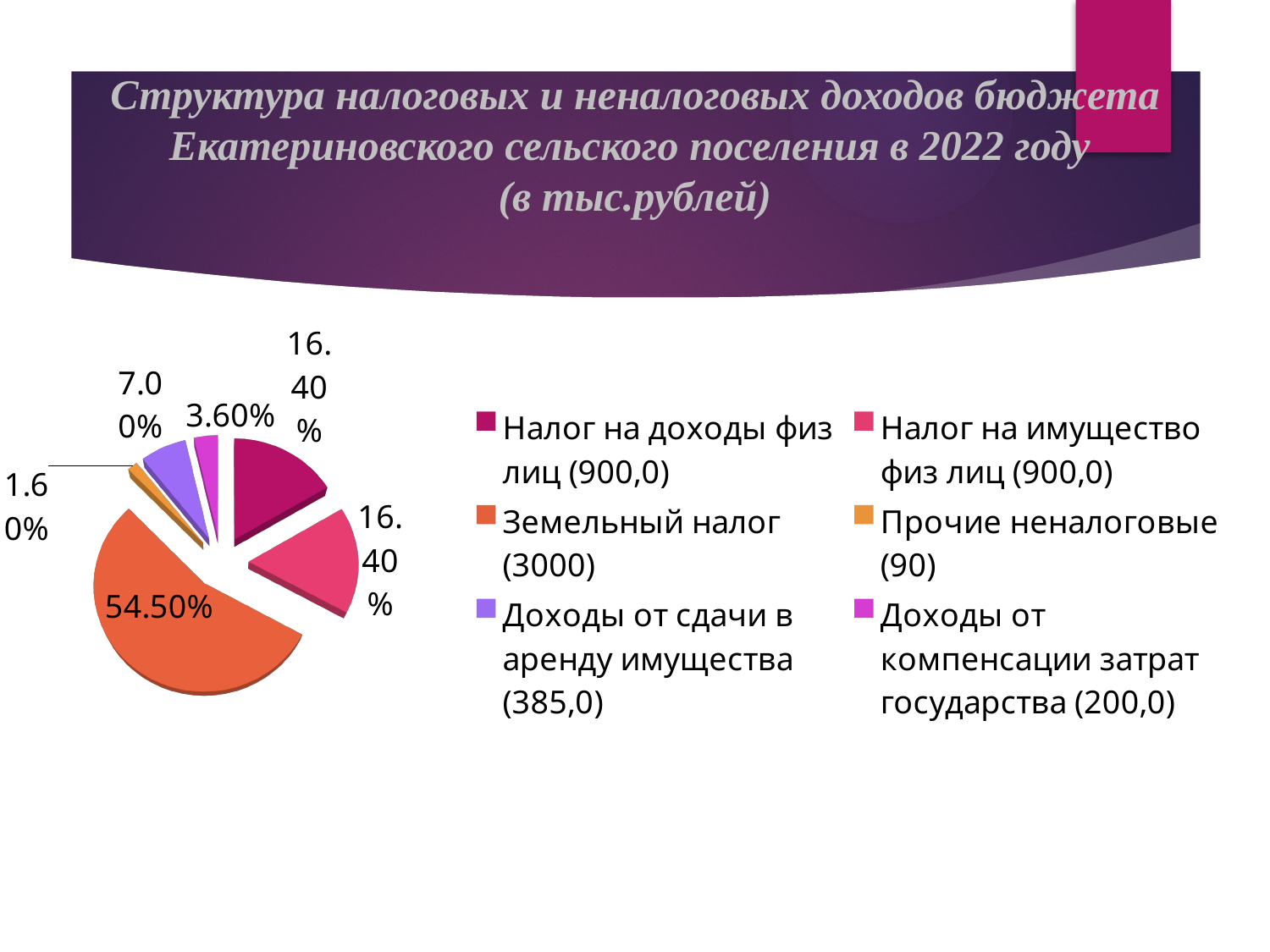
What percentage is shown for Доходы от сдачи в аренду имущества (385,0)? 7.00% What percentage is shown for Налог на доходы физ лиц (900,0)? 16.40% What percentage is shown for Прочие неналоговые (90)? 1.60% What share of the pie does Земельный налог (3000) account for? 54.50% What type of chart is shown on the slide? Pie chart Which category has the smallest slice of the pie? Прочие неналоговые (90) Which is larger: the share for Доходы от сдачи в аренду имущества or the share for Доходы от компенсации затрат государства? Доходы от сдачи в аренду имущества How many slices does the pie chart have? 6 What percentage is shown for Доходы от компенсации затрат государства (200,0)? 3.60% What colour is the slice for Земельный налог (3000)? Orange What is the difference in percentage points between Земельный налог and Налог на имущество физ лиц? 38.10% Which category has the largest slice of the pie? Земельный налог (3000)